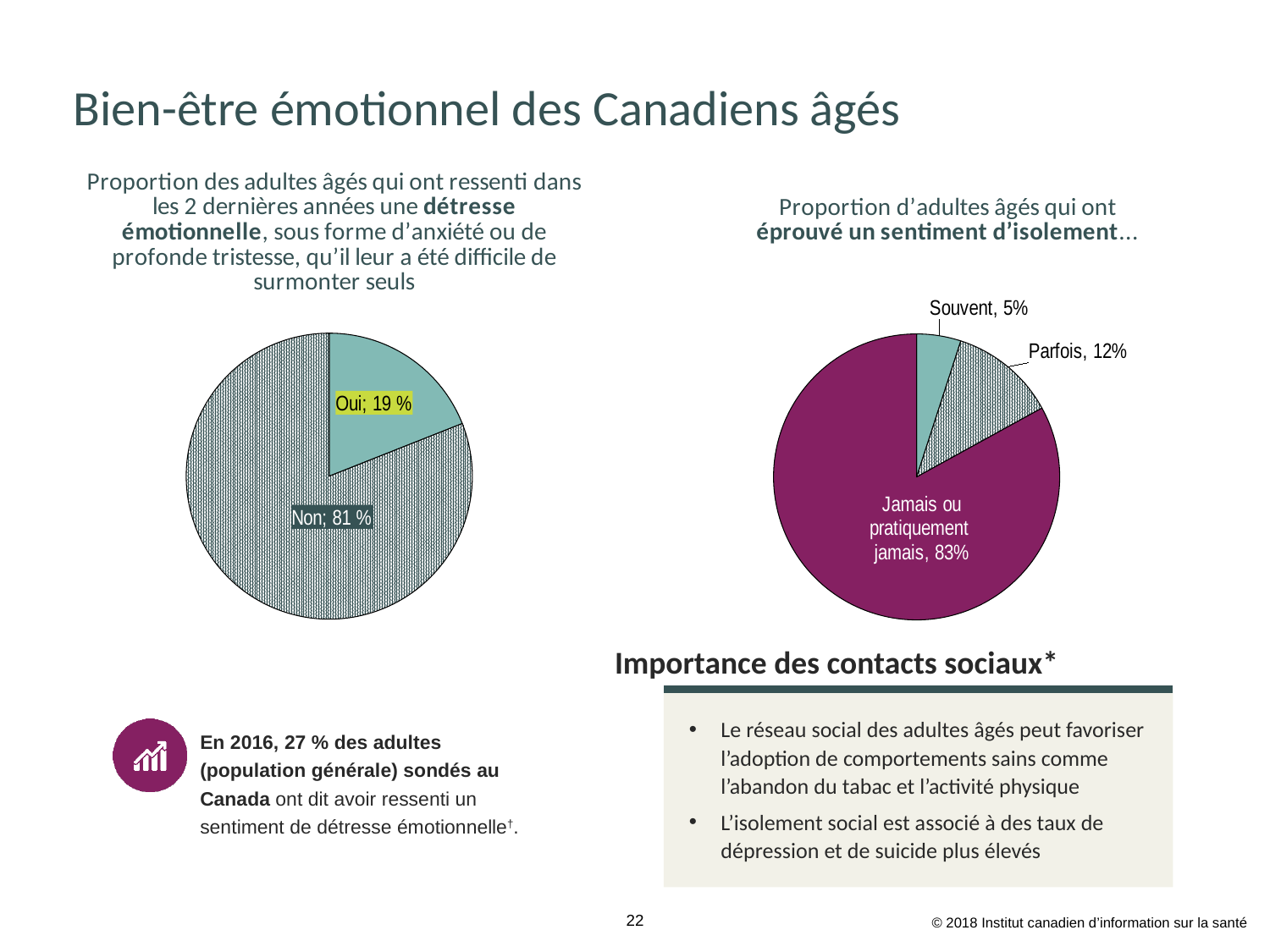
In the right pie chart on feelings of isolation, which is larger: "Parfois" or "Souvent"? Parfois In the right pie chart on feelings of isolation, what share of older adults answered "Parfois"? 12% In the left pie chart on emotional distress, what is the difference in percentage points between "Non" and "Oui"? 62 In the right pie chart on feelings of isolation, which category has the smallest slice? Souvent In the left pie chart on emotional distress, what share of older adults answered "Oui"? 19 % In the right pie chart on feelings of isolation, what share of older adults answered "Jamais ou pratiquement jamais"? 83% What type of chart is used on the left to show the proportion of older adults who felt emotional distress? Pie chart In the left pie chart on emotional distress, how many slices does the pie have? 2 In the right pie chart on feelings of isolation, how many categories are shown? 3 In the right pie chart on feelings of isolation, what share of older adults answered "Souvent"? 5% In the left pie chart on emotional distress, what share of older adults answered "Non"? 81 % In the left pie chart on emotional distress, which category has the largest slice? Non